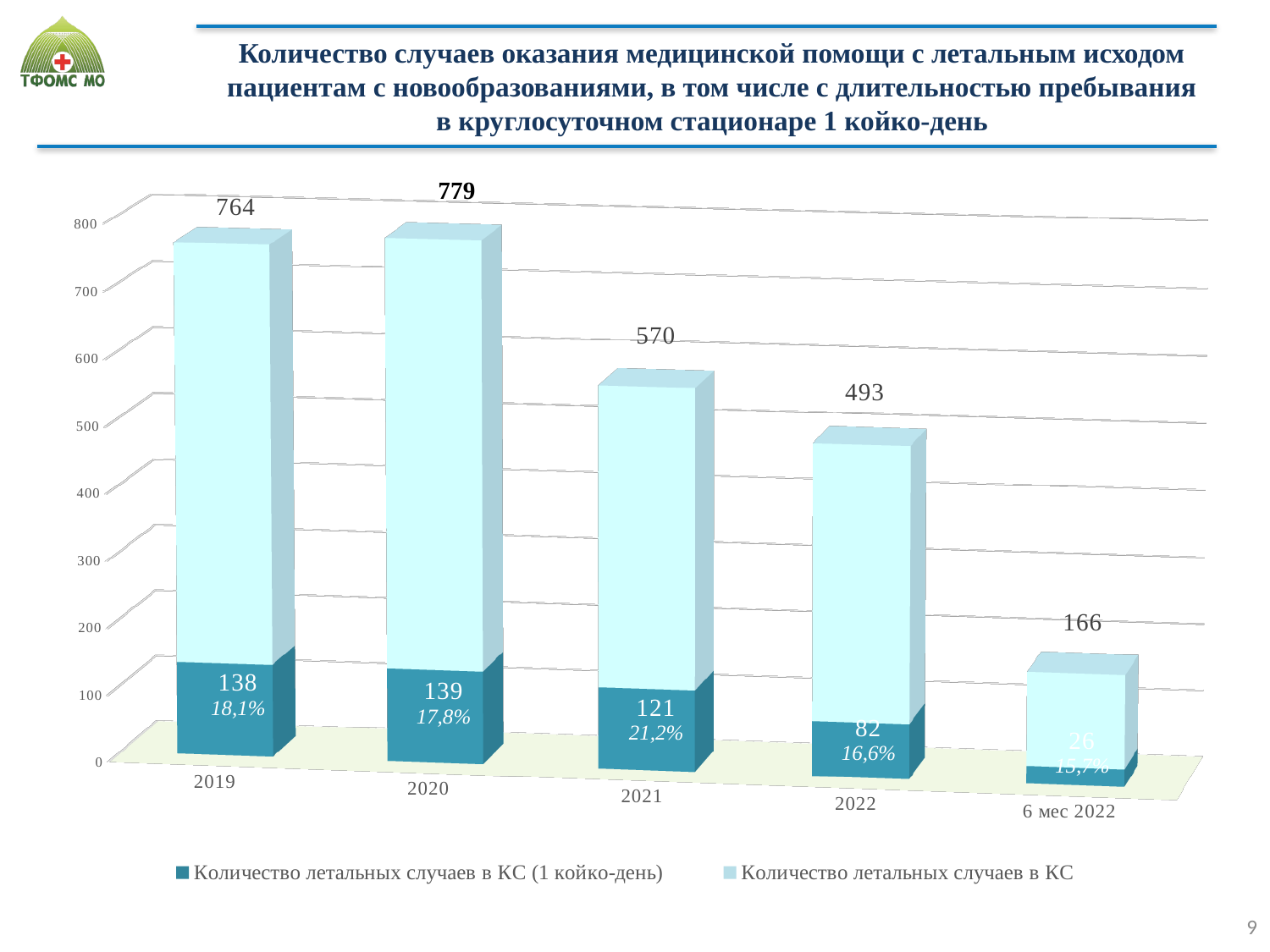
How many categories are shown on the x axis? 5 What is the value of 'Количество летальных случаев в КС' for '6 мес 2022'? 166 Which is larger: 'Количество летальных случаев в КС (1 койко-день)' for 2019 or for 2022? 2019 What is the difference between the 'Количество летальных случаев в КС' values for 2020 and 2021? 209 How many series does the legend list? 2 What kind of chart is shown on the slide? Bar chart Which category has the highest value for 'Количество летальных случаев в КС'? 2020 Which category has the lowest value for 'Количество летальных случаев в КС (1 койко-день)'? 6 мес 2022 What is the value of 'Количество летальных случаев в КС' for 2019? 764 What percentage is shown on the 'Количество летальных случаев в КС (1 койко-день)' bar for 2022? 16,6% What is the value of 'Количество летальных случаев в КС (1 койко-день)' for 2021? 121 Do the values for 'Количество летальных случаев в КС' rise or fall from 2020 to '6 мес 2022'? Fall